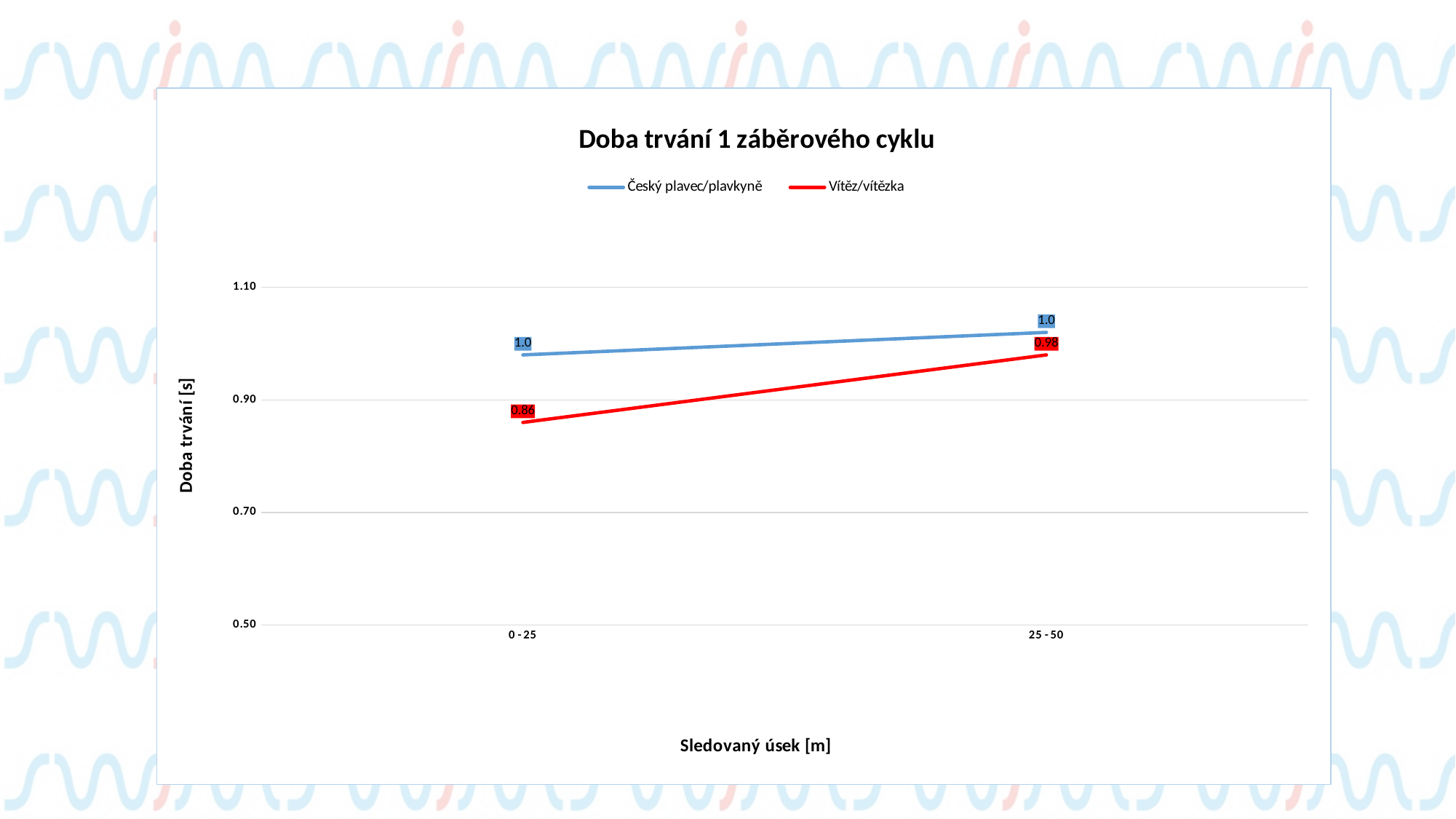
What is the value for Vítěz/vítězka in the 0 - 25 segment? 0.86 What is the title of the chart? Doba trvání 1 záběrového cyklu What is the difference between the Vítěz/vítězka values for 25 - 50 and 0 - 25? 0.12 Does the Vítěz/vítězka line rise or fall from 0 - 25 to 25 - 50? rise What is the value for Český plavec/plavkyně in the 0 - 25 segment? 1.0 What is the label of the y axis? Doba trvání [s] In the 0 - 25 segment, which series has the larger value, Český plavec/plavkyně or Vítěz/vítězka? Český plavec/plavkyně What type of chart is shown on the slide? line chart How many series does the legend list? 2 How many categories are shown on the x axis? 2 Is the value for Vítěz/vítězka in the 0 - 25 segment greater or less than 0.90? less What is the value for Vítěz/vítězka in the 25 - 50 segment? 0.98